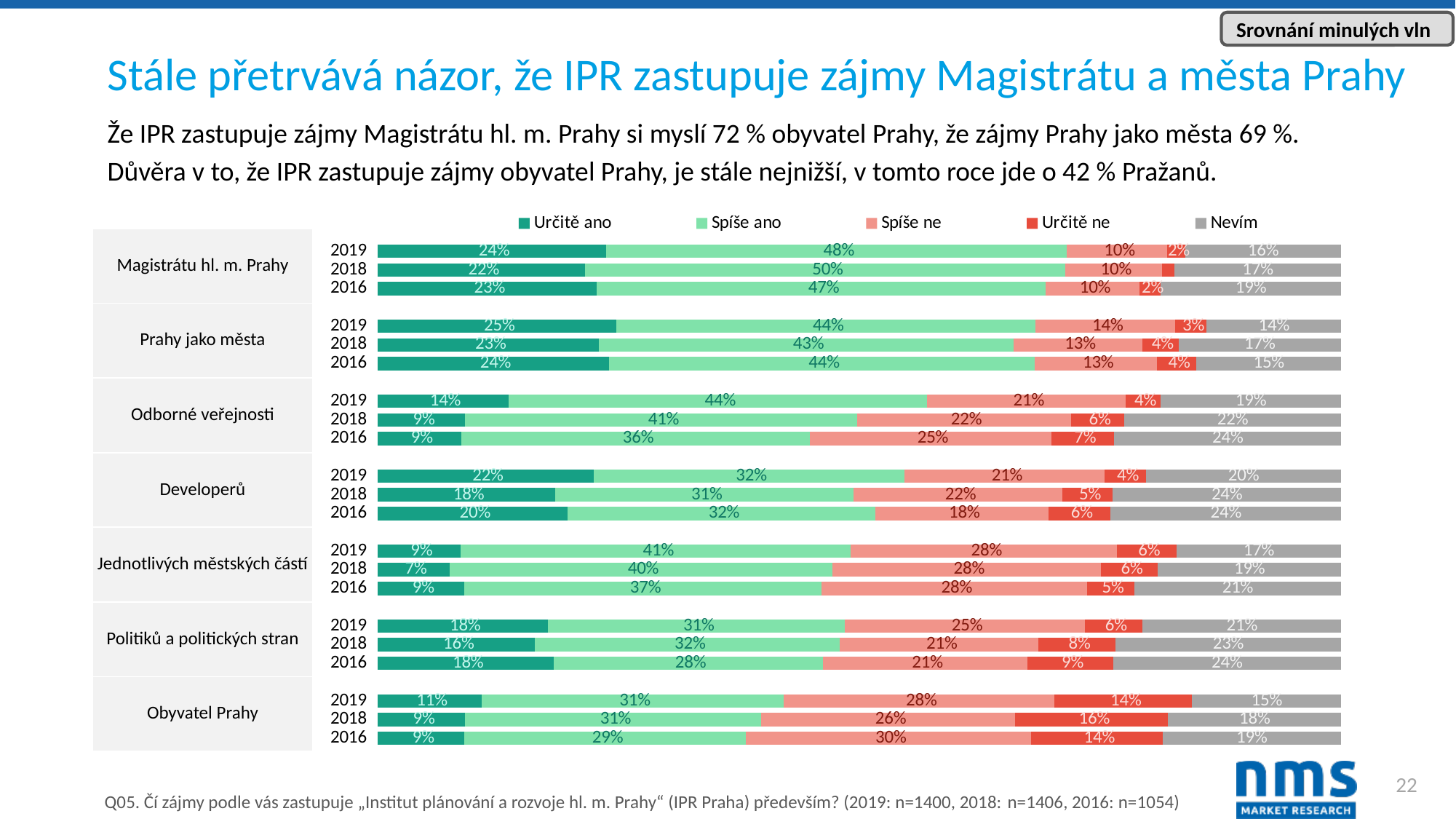
Among the 2019 bars, which category has the highest "Určitě ne" value? Obyvatel Prahy What percentage of respondents answered "Určitě ano" for "Magistrátu hl. m. Prahy" in 2019? 24% What is the "Spíše ano" value for "Prahy jako města" in 2019? 44% What is the "Nevím" value for "Odborné veřejnosti" in 2016? 24% What type of chart is shown on the slide? Stacked bar chart Does the "Nevím" value for "Obyvatel Prahy" rise or fall from 2016 to 2019? Fall How many percentage points higher is the "Spíše ano" value for "Magistrátu hl. m. Prahy" in 2019 than for "Obyvatel Prahy" in 2019? 17 percentage points How many categories (rows of interests) are shown in the chart? 7 What is the "Určitě ne" value for "Obyvatel Prahy" in 2018? 16% Which is larger: the "Spíše ne" value for "Developerů" in 2018 or for "Politiků a politických stran" in 2018? Developerů Among the 2019 bars, which category has the lowest "Určitě ano" value? Jednotlivých městských částí How many series does the legend list? 5